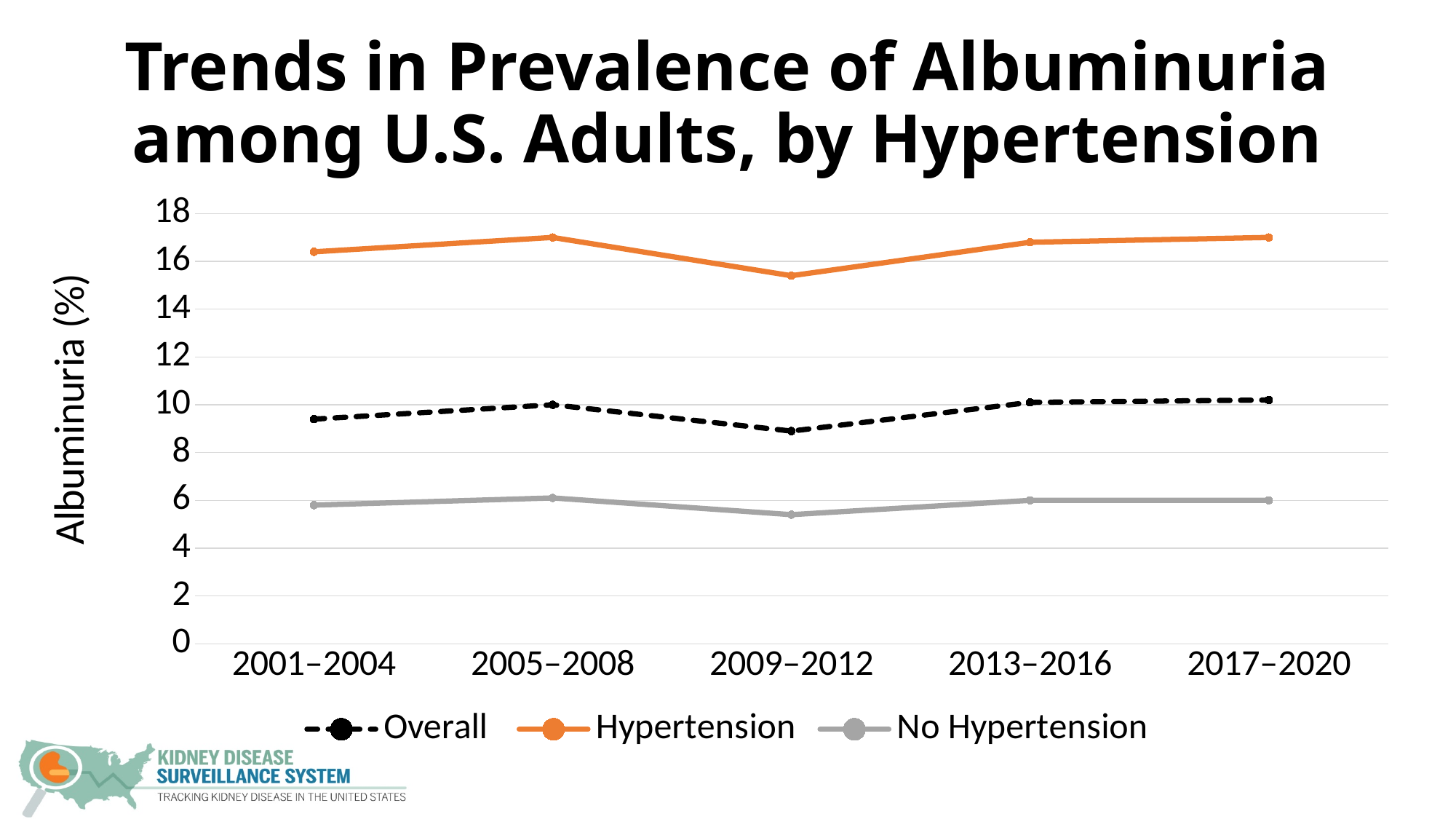
In which time period is the Overall series at its lowest? 2009–2012 Is the value for Hypertension in 2009–2012 greater or less than 16? less In which time period is the No Hypertension series at its lowest? 2009–2012 What kind of chart is shown on the slide? line chart How many time periods are shown on the x axis? 5 What is the label of the y axis? Albuminuria (%) Does the Hypertension series rise or fall from 2009–2012 to 2017–2020? rise Is the value for Hypertension in 2005–2008 greater or less than 16? greater How many series does the legend list? 3 Is the value for No Hypertension in 2009–2012 greater or less than 6? less In which time period is the Hypertension series at its lowest? 2009–2012 Which series has the larger value in 2013–2016, Hypertension or No Hypertension? Hypertension